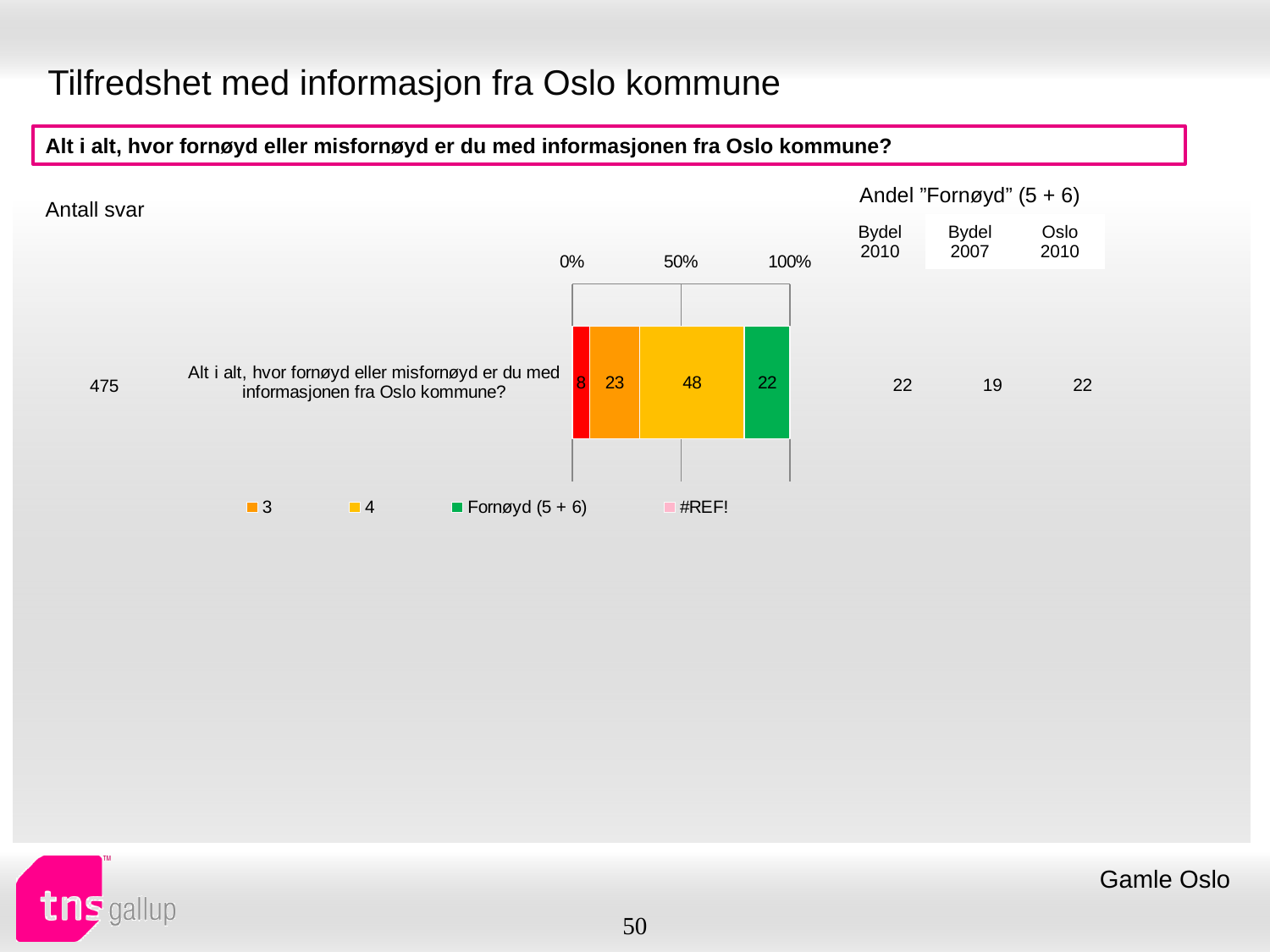
Which is larger in the stacked bar: the "3" segment or the "Fornøyd (5 + 6)" segment? 3 What is the value of the segment labelled "4" (yellow) in the stacked bar? 48 What is the last entry listed in the chart legend? #REF! What is the value of the red segment at the left end of the stacked bar? 8 How many series does the chart legend list? 4 What kind of chart is shown on the slide? bar chart Which segment of the stacked bar has the largest value? 4 Which segment of the stacked bar has the smallest value? the red segment (8) What is the difference between the "4" segment and the "3" segment in the stacked bar? 25 How many bars does the chart contain? 1 What is the value of the "Fornøyd (5 + 6)" (green) segment in the stacked bar? 22 What is the value of the segment labelled "3" (orange) in the stacked bar? 23